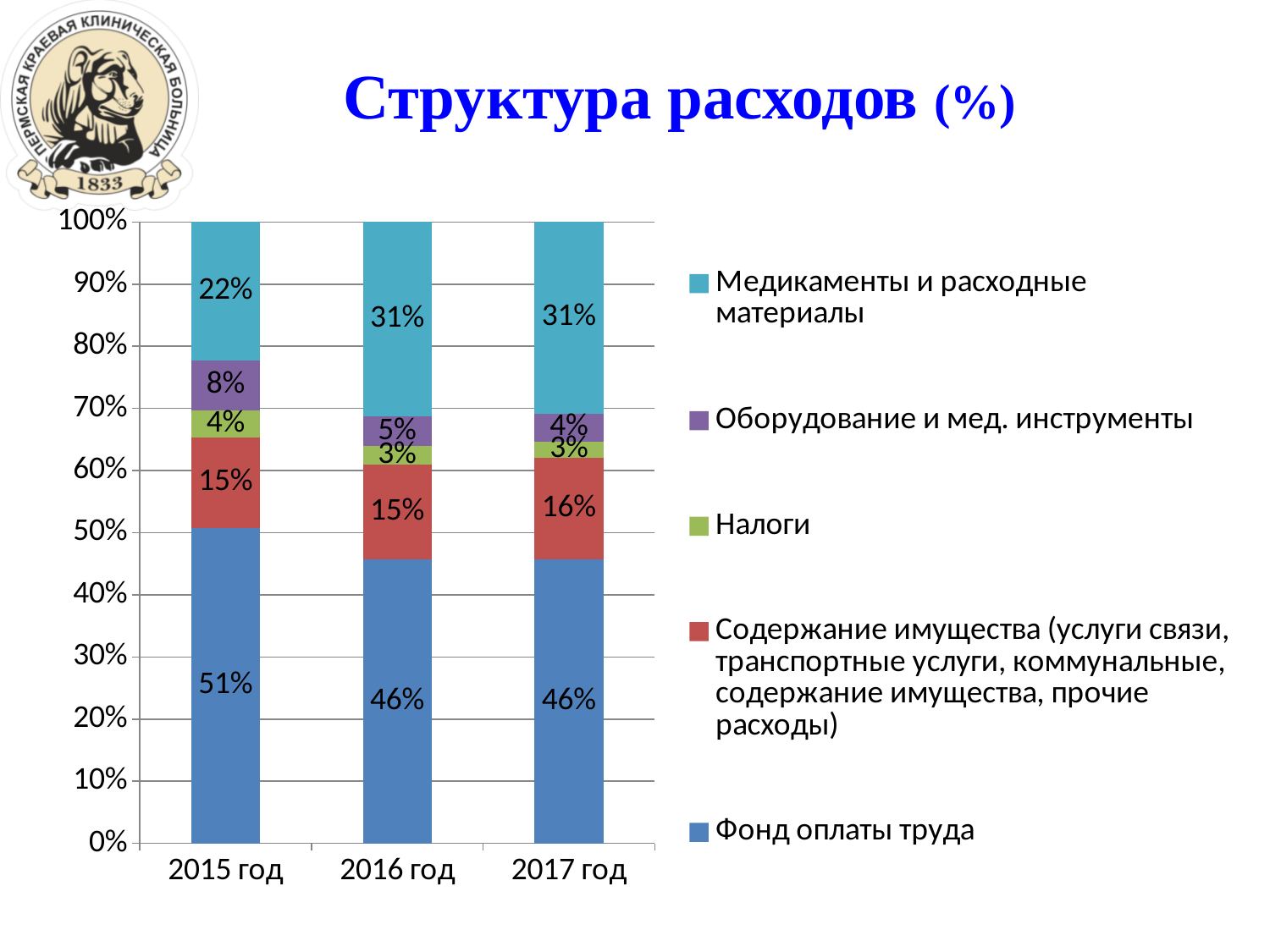
What kind of chart is shown on the slide? Stacked bar chart What is the value for Содержание имущества in 2017 год? 16% What is the difference between the Фонд оплаты труда share in 2015 год and in 2016 год? 5% How many series does the legend list? 5 How many years are shown on the x axis? 3 Which is larger: the Медикаменты и расходные материалы share in 2015 год or in 2016 год? 2016 год What is the value for Оборудование и мед. инструменты in 2016 год? 5% What is the value for Медикаменты и расходные материалы in 2017 год? 31% What is the value for Фонд оплаты труда in 2015 год? 51% In which year is the share of Медикаменты и расходные материалы lowest? 2015 год What is the value for Налоги in 2015 год? 4% In which year is the share of Оборудование и мед. инструменты highest? 2015 год